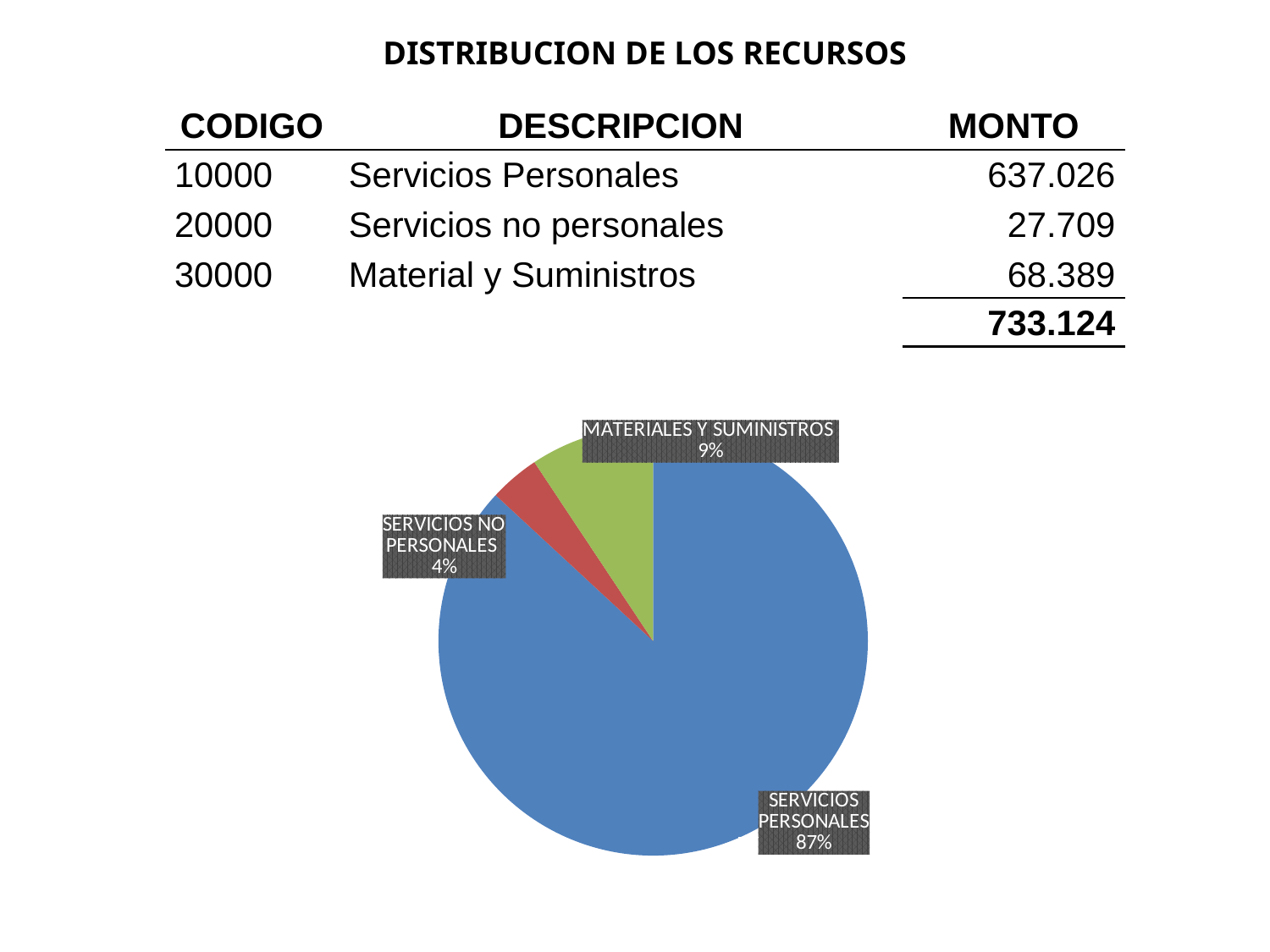
What share of the pie does SERVICIOS PERSONALES represent? 87% What colour is the MATERIALES Y SUMINISTROS slice in the pie chart? green Which slice of the pie chart is the largest? SERVICIOS PERSONALES How many slices does the pie chart have? 3 What is the difference in percentage points between the SERVICIOS PERSONALES slice and the MATERIALES Y SUMINISTROS slice? 78 Which is larger in the pie chart, MATERIALES Y SUMINISTROS or SERVICIOS NO PERSONALES? MATERIALES Y SUMINISTROS What share of the pie does SERVICIOS NO PERSONALES represent? 4% What share of the pie does MATERIALES Y SUMINISTROS represent? 9% What kind of chart is shown on the slide? pie chart What colour is the SERVICIOS PERSONALES slice in the pie chart? blue Which slice of the pie chart is the smallest? SERVICIOS NO PERSONALES What is the difference in percentage points between the MATERIALES Y SUMINISTROS slice and the SERVICIOS NO PERSONALES slice? 5